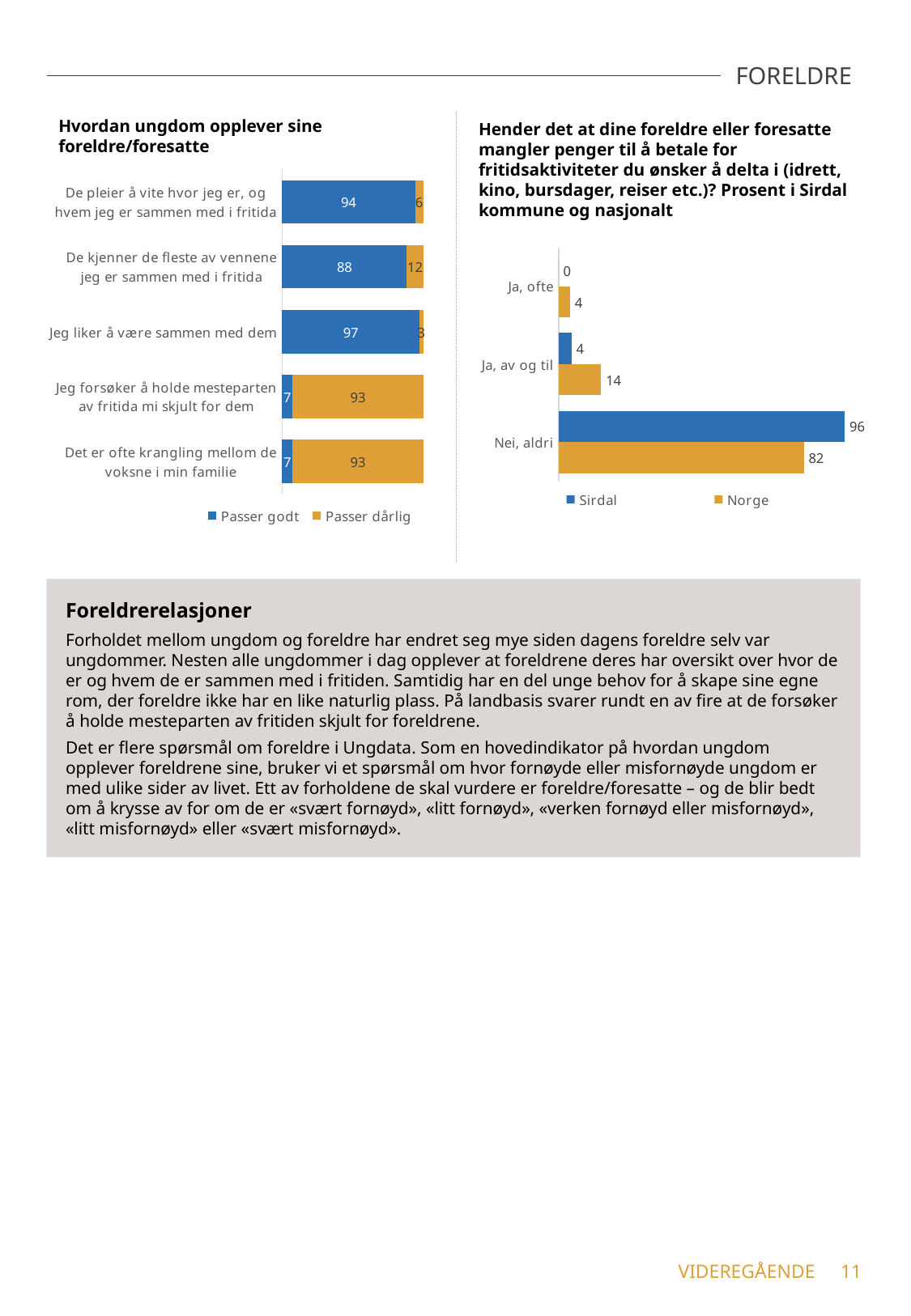
In the right chart about parents lacking money for leisure activities, which is larger for 'Ja, av og til': Sirdal or Norge? Norge In the left chart 'Hvordan ungdom opplever sine foreldre/foresatte', what is the 'Passer godt' value for 'De pleier å vite hvor jeg er, og hvem jeg er sammen med i fritida'? 94 In the right chart about parents lacking money for leisure activities, what is the value for Sirdal for 'Nei, aldri'? 96 In the left chart 'Hvordan ungdom opplever sine foreldre/foresatte', which category has the highest 'Passer godt' value? Jeg liker å være sammen med dem In the left chart 'Hvordan ungdom opplever sine foreldre/foresatte', how many series does the legend list? 2 In the right chart about parents lacking money for leisure activities, what is the difference between Sirdal and Norge for 'Nei, aldri'? 14 In the right chart about parents lacking money for leisure activities, what is the value for Norge for 'Ja, av og til'? 14 In the right chart about parents lacking money for leisure activities, what is the value for Sirdal for 'Ja, ofte'? 0 In the left chart 'Hvordan ungdom opplever sine foreldre/foresatte', how many categories are shown? 5 In the left chart 'Hvordan ungdom opplever sine foreldre/foresatte', what is the total of the stacked bar for 'Jeg forsøker å holde mesteparten av fritida mi skjult for dem'? 100 What type of chart is the right chart about parents lacking money for leisure activities? Bar chart In the left chart 'Hvordan ungdom opplever sine foreldre/foresatte', what is the 'Passer dårlig' value for 'De kjenner de fleste av vennene jeg er sammen med i fritida'? 12